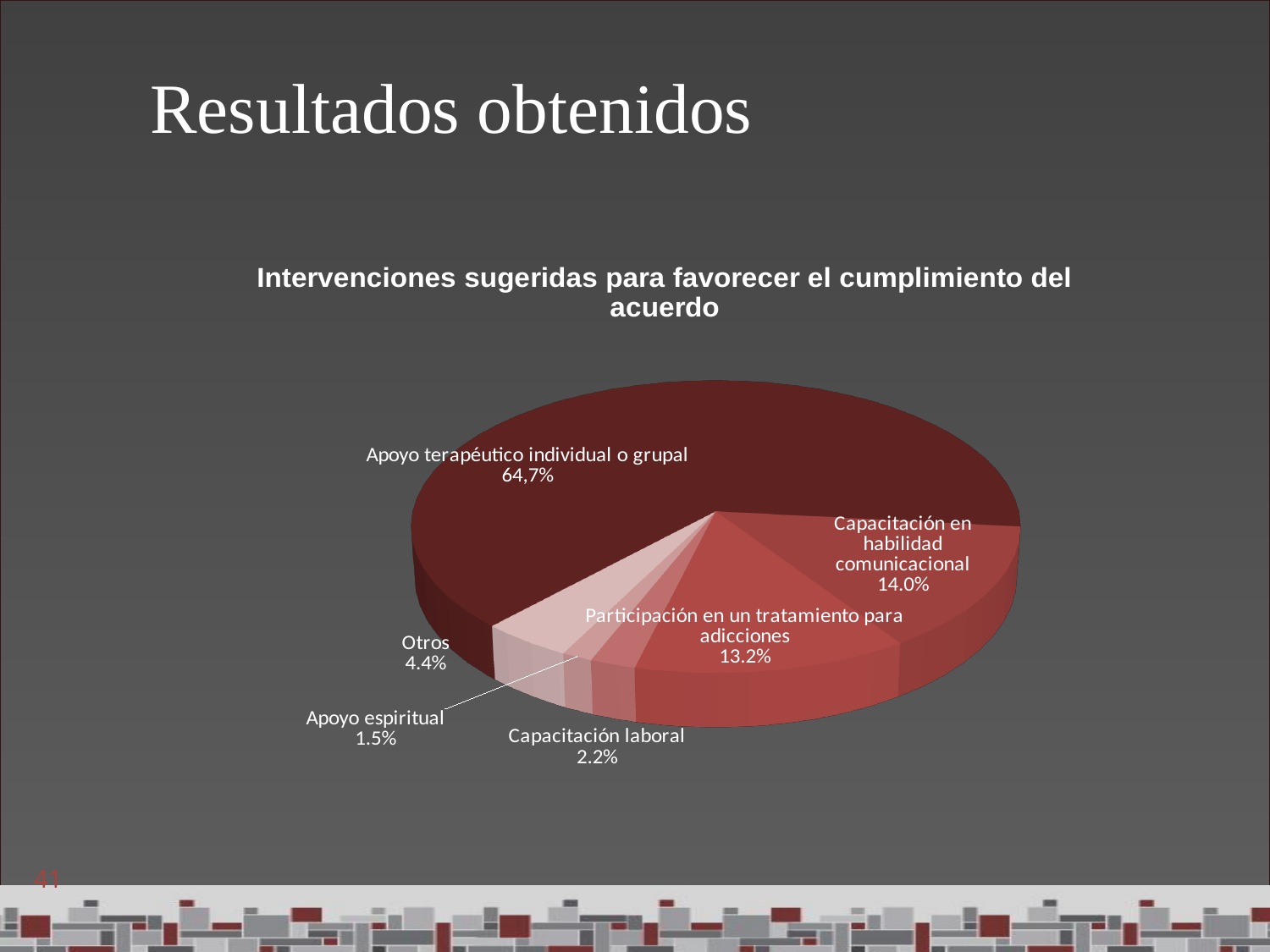
Which category has the smallest share of the pie? Apoyo espiritual What percentage is shown for Capacitación en habilidad comunicacional? 14.0% What kind of chart is shown on the slide? pie chart What percentage is shown for Apoyo espiritual? 1.5% What percentage is shown for Apoyo terapéutico individual o grupal? 64,7% What is the title of the chart? Intervenciones sugeridas para favorecer el cumplimiento del acuerdo What percentage is shown for Participación en un tratamiento para adicciones? 13.2% Which is larger, the share for Otros or the share for Capacitación laboral? Otros Which category has the largest share of the pie? Apoyo terapéutico individual o grupal What is the difference in percentage points between Capacitación laboral and Apoyo espiritual? 0.7 How many slices does the pie chart have? 6 What percentage is shown for Otros? 4.4%